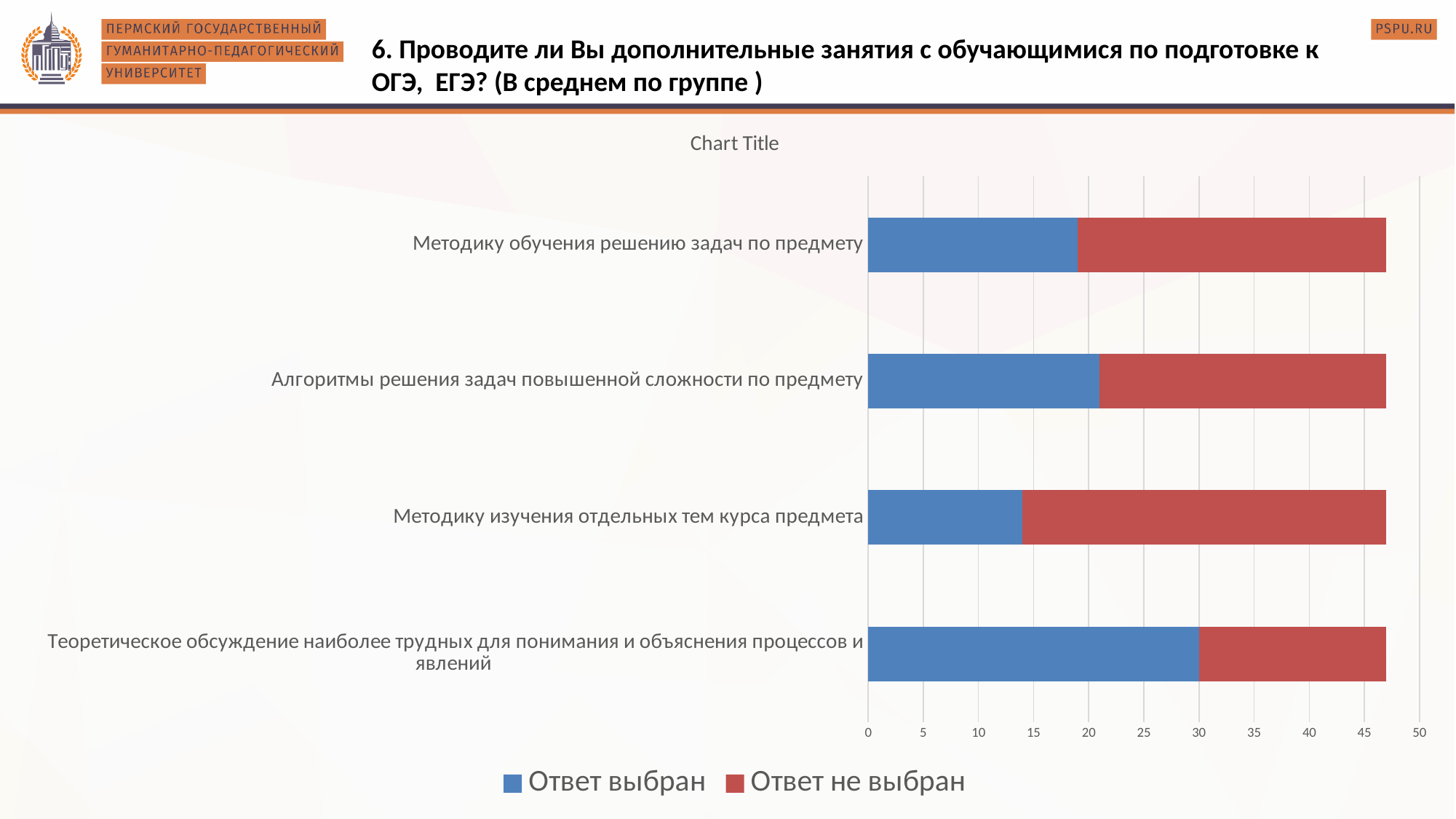
Which category has the smallest 'Ответ выбран' value? Методику изучения отдельных тем курса предмета Is the 'Ответ выбран' value for 'Методику обучения решению задач по предмету' greater or less than 15? greater Which category has the largest 'Ответ выбран' value? Теоретическое обсуждение наиболее трудных для понимания и объяснения процессов и явлений Is the 'Ответ выбран' value for 'Алгоритмы решения задач повышенной сложности по предмету' greater or less than 25? less Is the 'Ответ выбран' value for 'Методику изучения отдельных тем курса предмета' greater or less than 20? less What colour represents the 'Ответ не выбран' series in the legend? red How many categories are shown on the chart? 4 What kind of chart is shown on the slide? bar chart Which has the larger 'Ответ выбран' value: 'Методику изучения отдельных тем курса предмета' or 'Теоретическое обсуждение наиболее трудных для понимания и объяснения процессов и явлений'? Теоретическое обсуждение наиболее трудных для понимания и объяснения процессов и явлений How many series does the legend list? 2